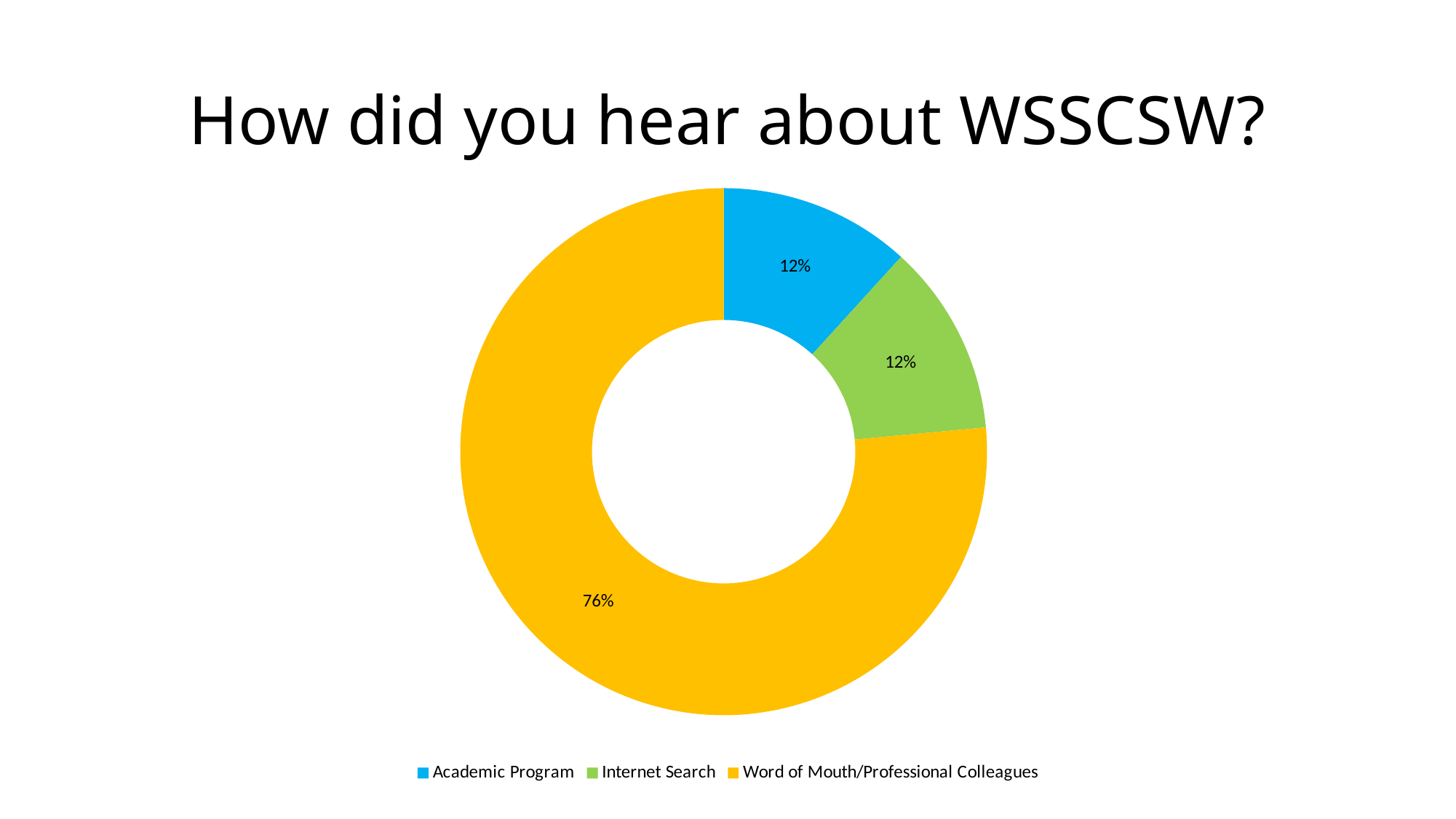
Which category has the largest share of the chart? Word of Mouth/Professional Colleagues What colour represents Internet Search in the chart? Green What is the difference in percentage points between Word of Mouth/Professional Colleagues and Academic Program? 64 What is the combined share of Academic Program and Internet Search? 24% What share of respondents heard about WSSCSW through an Academic Program? 12% How many categories does the chart show? 3 What share of respondents heard about WSSCSW through Internet Search? 12% Which is larger: the share for Word of Mouth/Professional Colleagues or the share for Internet Search? Word of Mouth/Professional Colleagues What share of respondents heard about WSSCSW through Word of Mouth/Professional Colleagues? 76% What kind of chart is shown on the slide? Doughnut (pie) chart What is the title of the slide? How did you hear about WSSCSW?